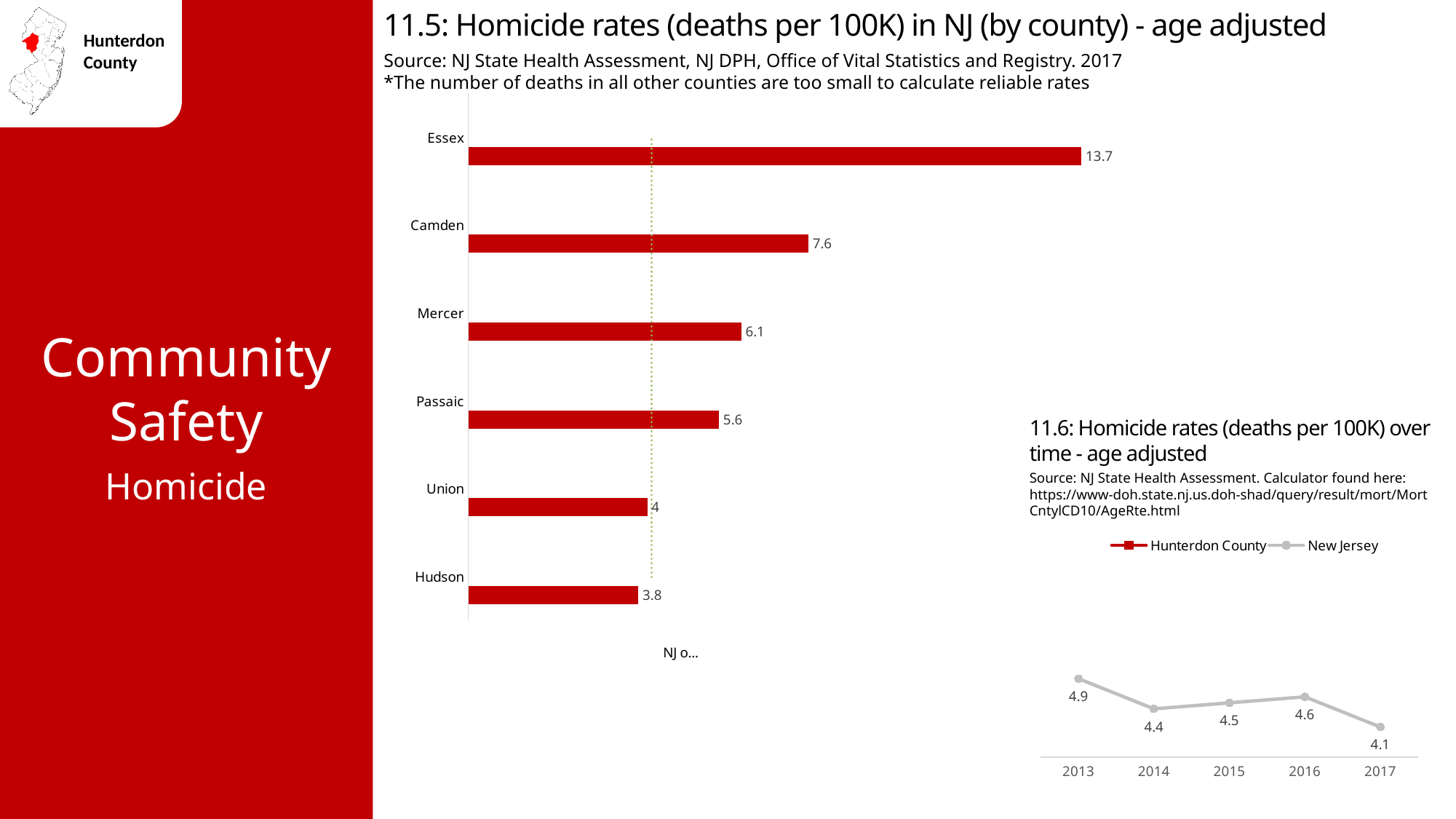
How many counties are shown in the chart '11.5: Homicide rates (deaths per 100K) in NJ (by county) - age adjusted'? 6 What type of chart is '11.5: Homicide rates (deaths per 100K) in NJ (by county) - age adjusted'? Bar chart In the chart '11.5: Homicide rates (deaths per 100K) in NJ (by county) - age adjusted', which county has the highest homicide rate? Essex In the chart '11.6: Homicide rates (deaths per 100K) over time - age adjusted', what is the New Jersey homicide rate in 2013? 4.9 In the chart '11.6: Homicide rates (deaths per 100K) over time - age adjusted', what is the New Jersey homicide rate in 2017? 4.1 In the chart '11.5: Homicide rates (deaths per 100K) in NJ (by county) - age adjusted', what is the homicide rate for Passaic? 5.6 In the chart '11.5: Homicide rates (deaths per 100K) in NJ (by county) - age adjusted', what is the difference between the rates for Essex and Camden? 6.1 In the chart '11.5: Homicide rates (deaths per 100K) in NJ (by county) - age adjusted', which county has the lowest homicide rate? Hudson In the chart '11.5: Homicide rates (deaths per 100K) in NJ (by county) - age adjusted', what is the homicide rate for Essex? 13.7 How many series does the legend list in the chart '11.6: Homicide rates (deaths per 100K) over time - age adjusted'? 2 In the chart '11.5: Homicide rates (deaths per 100K) in NJ (by county) - age adjusted', which has a higher homicide rate, Mercer or Union? Mercer In the chart '11.6: Homicide rates (deaths per 100K) over time - age adjusted', which year has the lowest New Jersey homicide rate? 2017